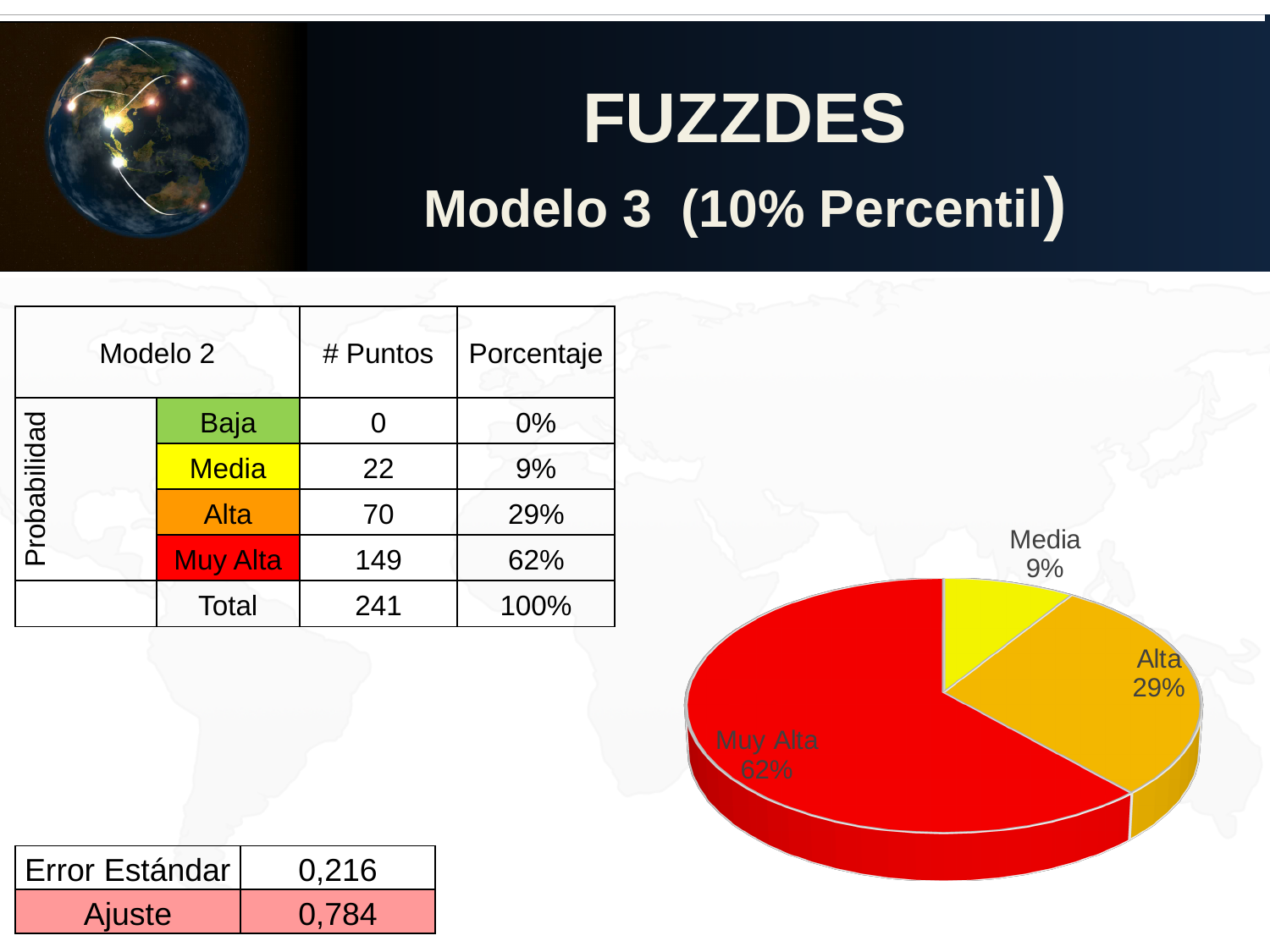
What share of the pie does the Media slice represent? 9% What kind of chart is shown on the slide? pie chart How many slices are labelled in the pie chart? 3 Which slice of the pie chart is the largest? Muy Alta What share of the pie does the Muy Alta slice represent? 62% What is the difference in percentage points between the Alta and Media slices? 20 What colour is the Media slice in the pie chart? yellow What share of the pie does the Alta slice represent? 29% Which slice of the pie chart is the smallest? Media Which slice is larger, Alta or Media? Alta What is the difference in percentage points between the Muy Alta and Alta slices? 33 What colour is the Muy Alta slice in the pie chart? red